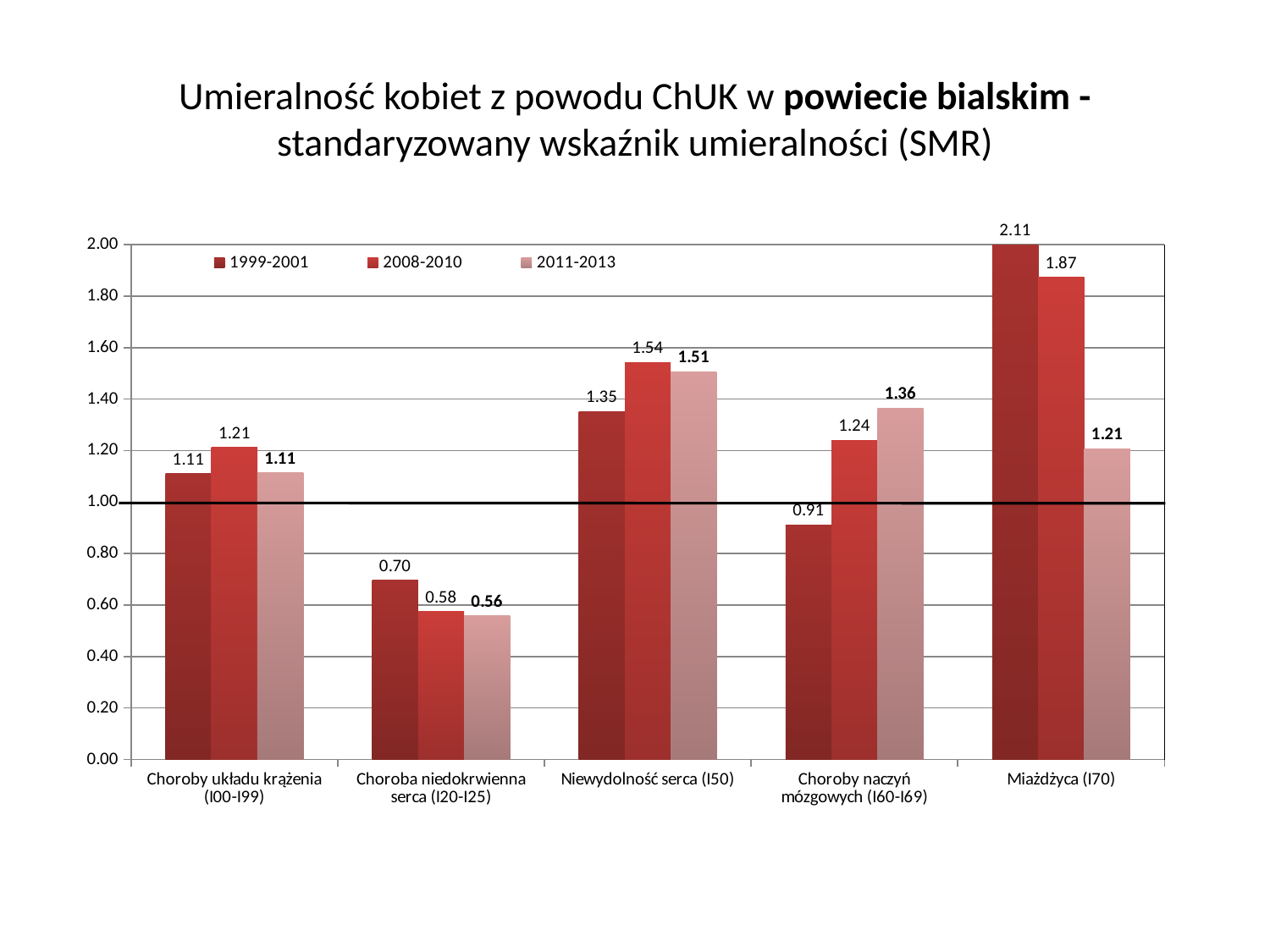
Which category has the lowest value in the 1999-2001 series? Choroba niedokrwienna serca (I20-I25) What kind of chart is shown on the slide? bar chart Across the three periods, do the values for Choroby naczyń mózgowych (I60-I69) rise or fall? rise How many series does the legend list? 3 For Niewydolność serca (I50), which is larger: the 1999-2001 value or the 2008-2010 value? 2008-2010 Which category has the highest value in the 2008-2010 series? Miażdżyca (I70) What is the difference between the 1999-2001 and 2011-2013 values for Miażdżyca (I70)? 0.90 What is the value for Choroby naczyń mózgowych (I60-I69) in the 2008-2010 series? 1.24 How many categories are shown on the x axis? 5 What is the value for Miażdżyca (I70) in the 1999-2001 series? 2.11 What is the value for Choroba niedokrwienna serca (I20-I25) in the 2011-2013 series? 0.56 Is the 2011-2013 value for Choroby naczyń mózgowych (I60-I69) greater or less than 1.00? greater